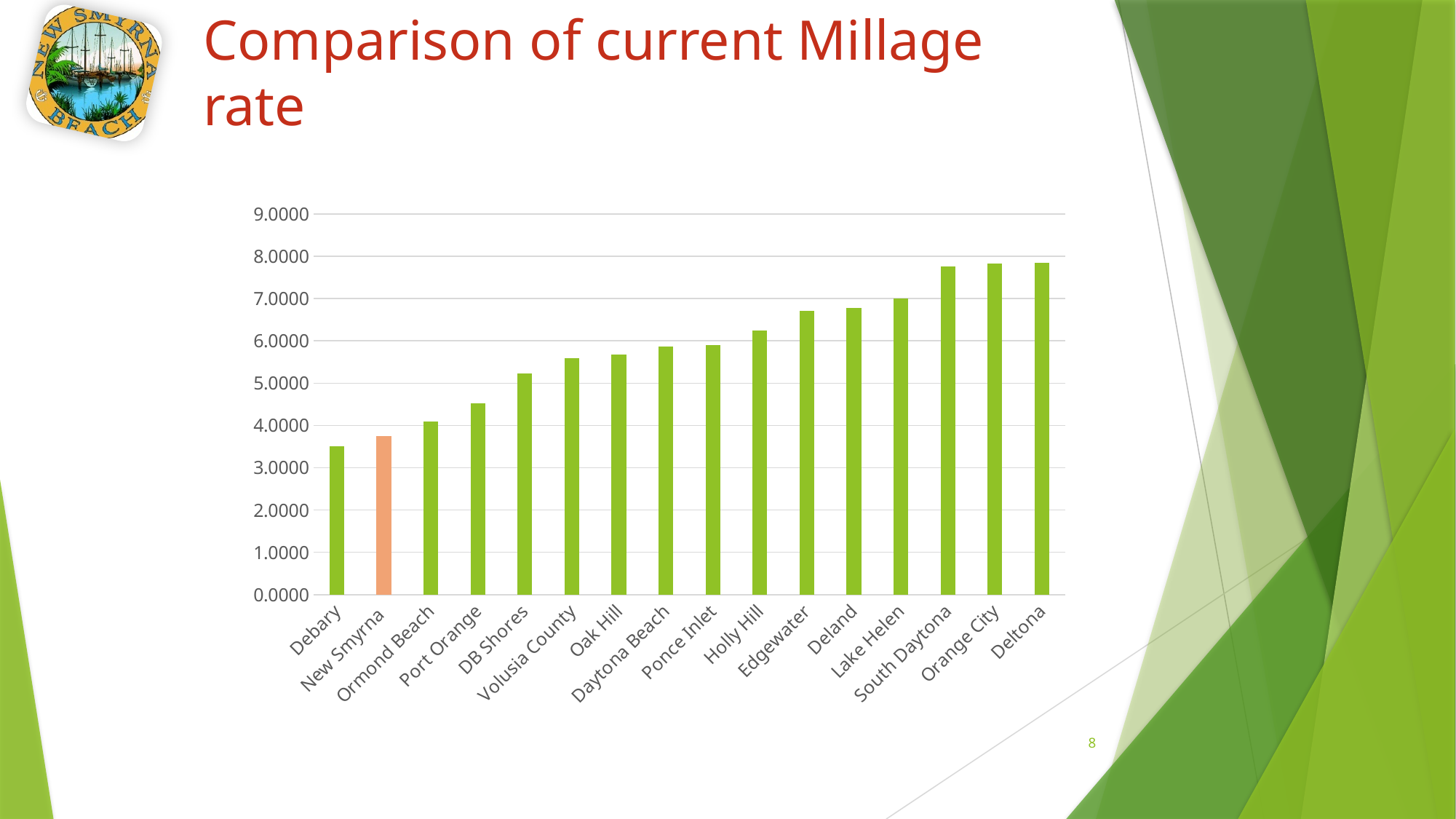
Do the values rise or fall moving from left to right along the x axis? rise What kind of chart is shown on the slide? bar chart Which category's bar is shown in a different colour (orange) from the others? New Smyrna Which has a higher millage rate, Deland or Oak Hill? Deland Which category has the lowest millage rate in the chart? Debary Is the value for South Daytona greater or less than 7.0000? greater Is the value for Debary greater or less than 4.0000? less How many categories are shown on the x axis of the chart? 16 Is the value for Deltona greater or less than 8.0000? less